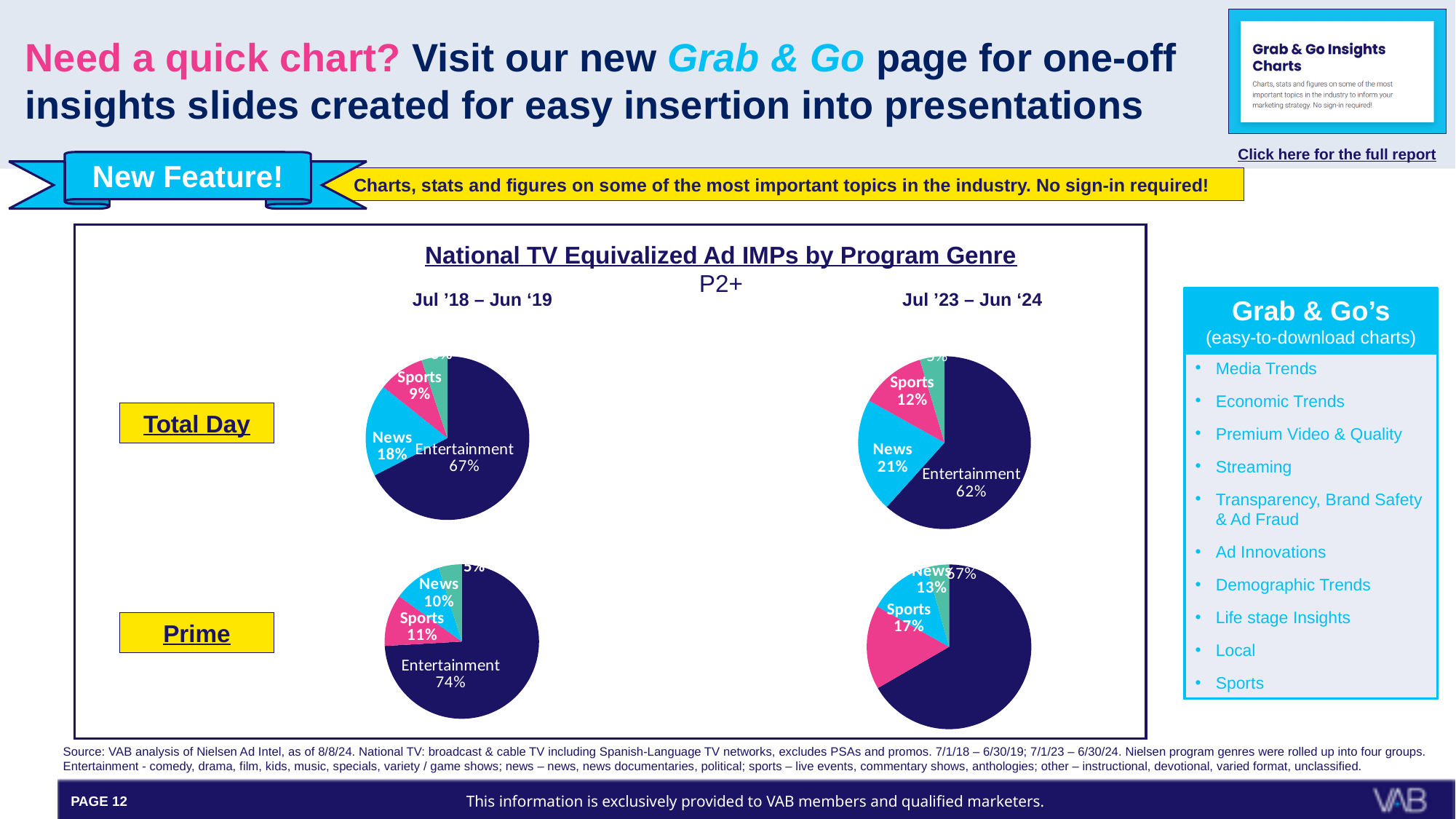
In the Total Day pie chart for Jul '23 – Jun '24, which labeled genre has the largest share? Entertainment In the Prime pie chart for Jul '18 – Jun '19, what share does Sports have? 11% In the Total Day pie chart for Jul '23 – Jun '24, what share does News have? 21% How many pie charts are shown on the slide? 4 What is the difference between the Sports share in the Total Day chart for Jul '23 – Jun '24 and the Total Day chart for Jul '18 – Jun '19? 3 percentage points What type of charts are used to show National TV Equivalized Ad IMPs by Program Genre? Pie charts In the Total Day pie chart for Jul '18 – Jun '19, which is larger, News or Sports? News In the Prime pie chart for Jul '23 – Jun '24, which is larger, Sports or News? Sports In the Prime pie chart for Jul '23 – Jun '24, what share does Entertainment have? 67% In the Total Day pie chart for Jul '18 – Jun '19, what share does Entertainment have? 67% What is the title of the chart section on the slide? National TV Equivalized Ad IMPs by Program Genre What is the difference between the Entertainment share in the Prime chart for Jul '18 – Jun '19 and the Prime chart for Jul '23 – Jun '24? 7 percentage points